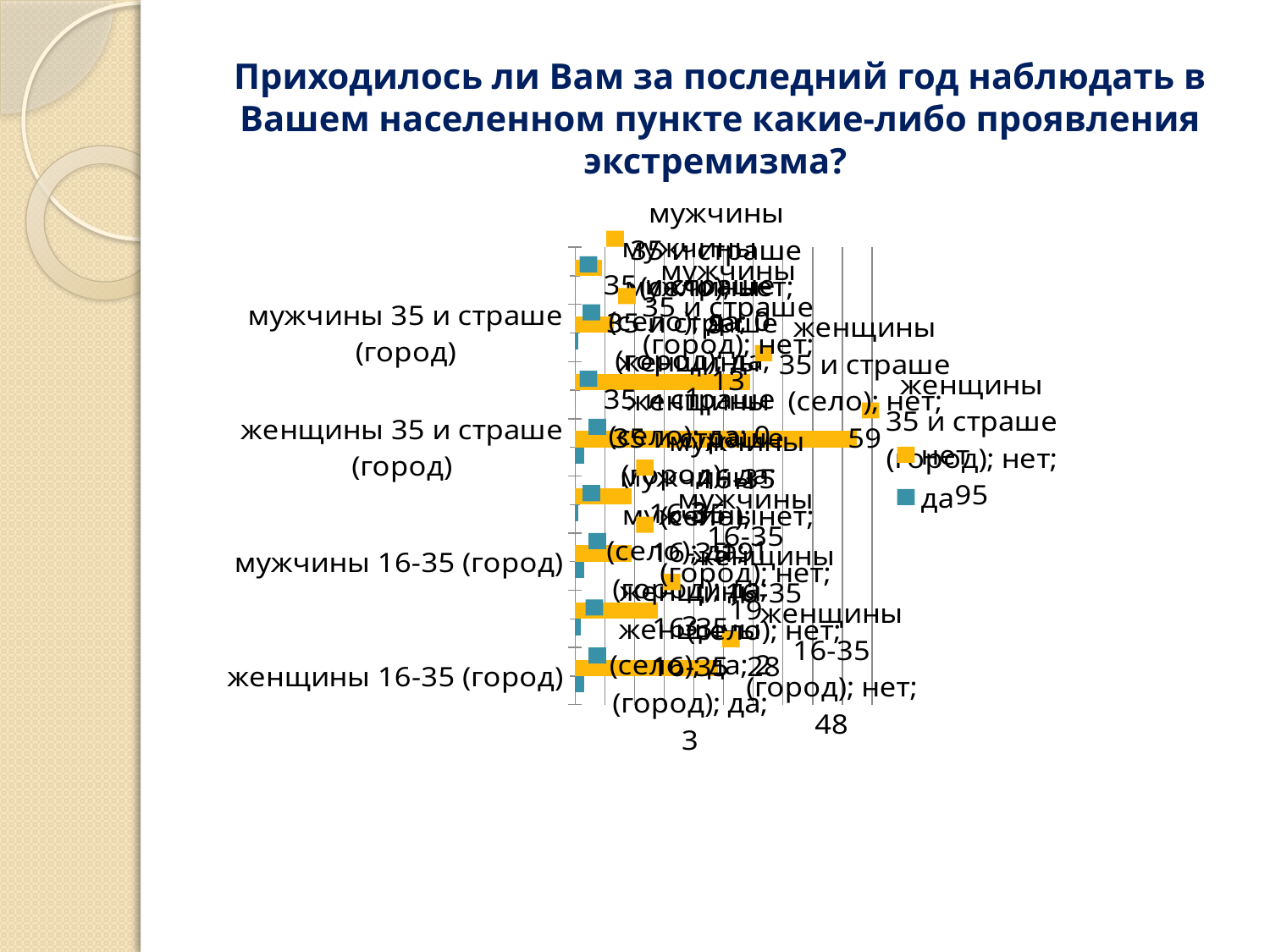
For женщины 16-35 (город), which is larger: 'нет' or 'да'? нет What is the difference between 'нет' and 'да' for женщины 16-35 (город)? 45 Which series is shown in orange in the chart? нет What are the two series named in the chart legend? нет and да For женщины 35 и страше (город), which is larger: 'нет' or 'да'? нет What is the value of 'да' for женщины 16-35 (город)? 3 What is the value of 'нет' for женщины 35 и страше (город)? 95 How many series does the chart legend list? 2 What is the value of 'нет' for женщины 16-35 (город)? 48 What kind of chart is shown on the slide? bar chart Which bar is the longest in the chart? женщины 35 и страше (город), нет